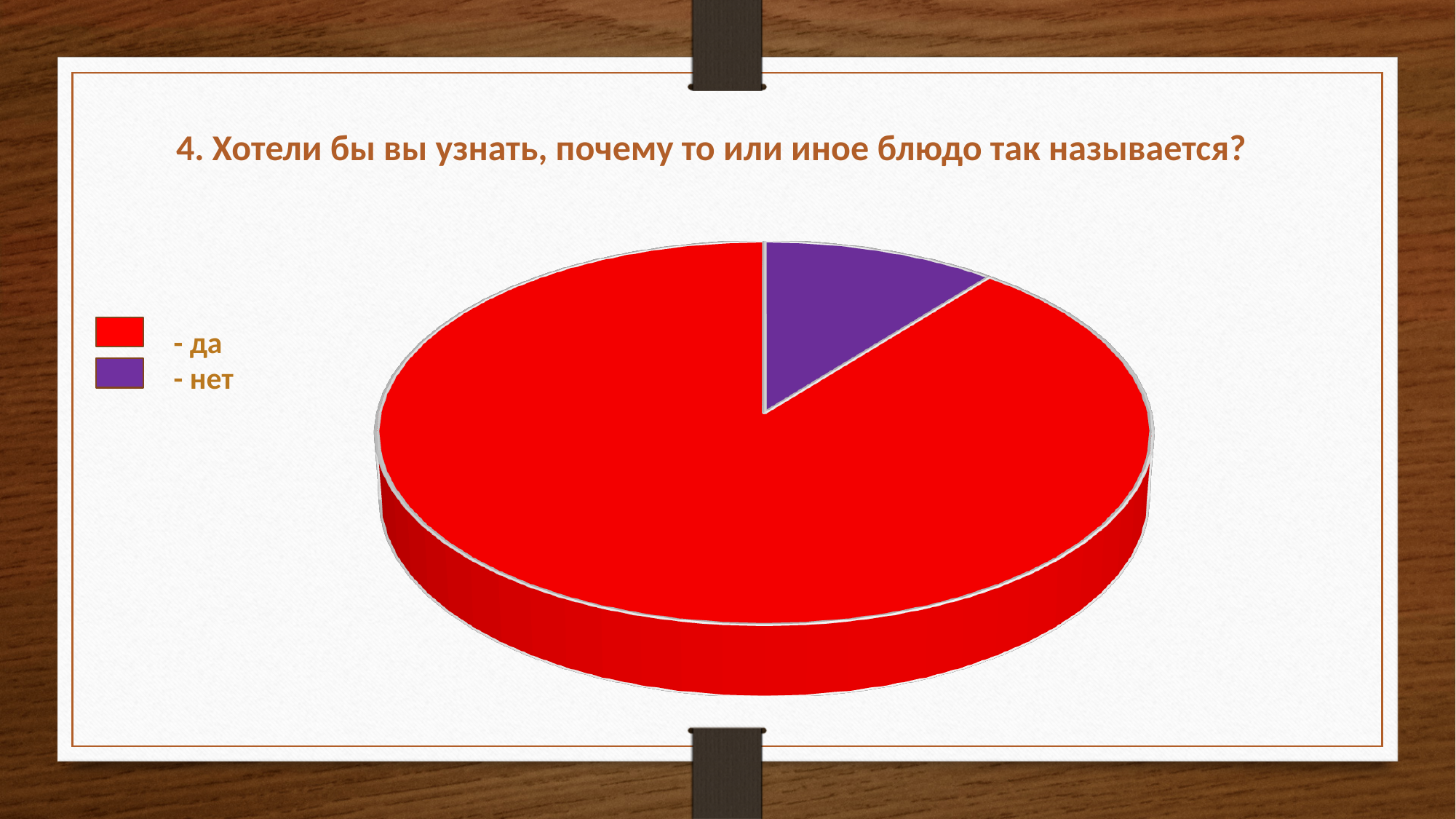
How many entries does the legend list? 2 Which answer has the largest slice of the pie? да What is the title of the chart? 4. Хотели бы вы узнать, почему то или иное блюдо так называется? What colour is the slice for "нет"? purple What kind of chart is shown on the slide? pie chart How many slices does the pie chart have? 2 Which answer has the smallest slice of the pie? нет Which slice is larger, "да" or "нет"? да